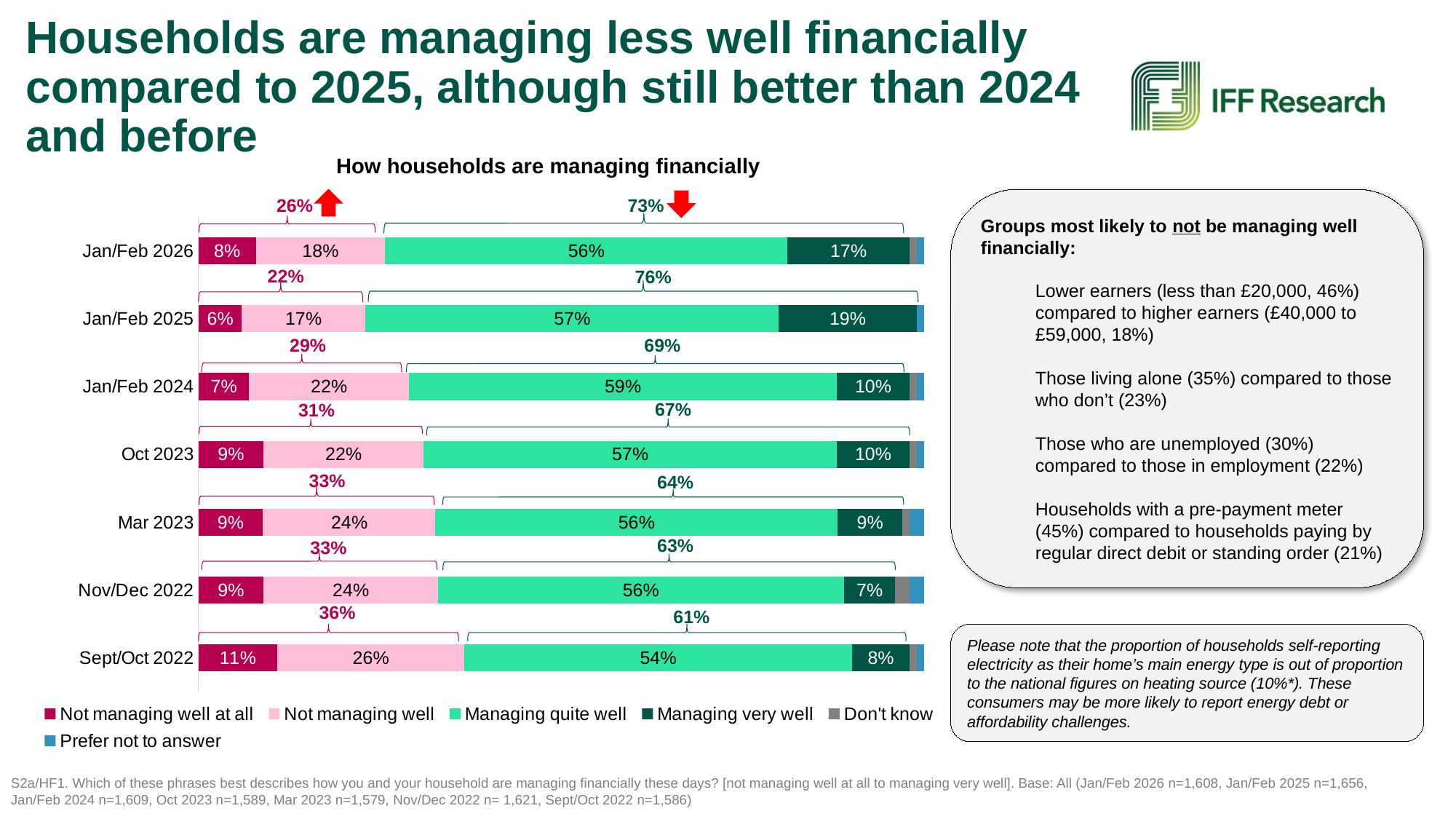
What kind of chart is used to show how households are managing financially? Stacked bar chart What percentage of households were 'Managing quite well' in Jan/Feb 2026? 56% How many survey waves are shown on the chart? 7 How many series does the chart legend list? 6 What is the combined share of 'Not managing well at all' and 'Not managing well' for Mar 2023? 33% What percentage of households were 'Not managing well at all' in Sept/Oct 2022? 11% In which wave was the 'Managing very well' share lowest? Nov/Dec 2022 Does the 'Not managing well at all' share rise or fall from Sept/Oct 2022 to Jan/Feb 2025? Fall In which wave was the 'Managing very well' share highest? Jan/Feb 2025 Which wave had a larger 'Managing quite well' share, Jan/Feb 2024 or Oct 2023? Jan/Feb 2024 By how many percentage points did the 'Not managing well' share fall from Sept/Oct 2022 (26%) to Jan/Feb 2026 (18%)? 8 percentage points What percentage of households were 'Managing very well' in Jan/Feb 2025? 19%